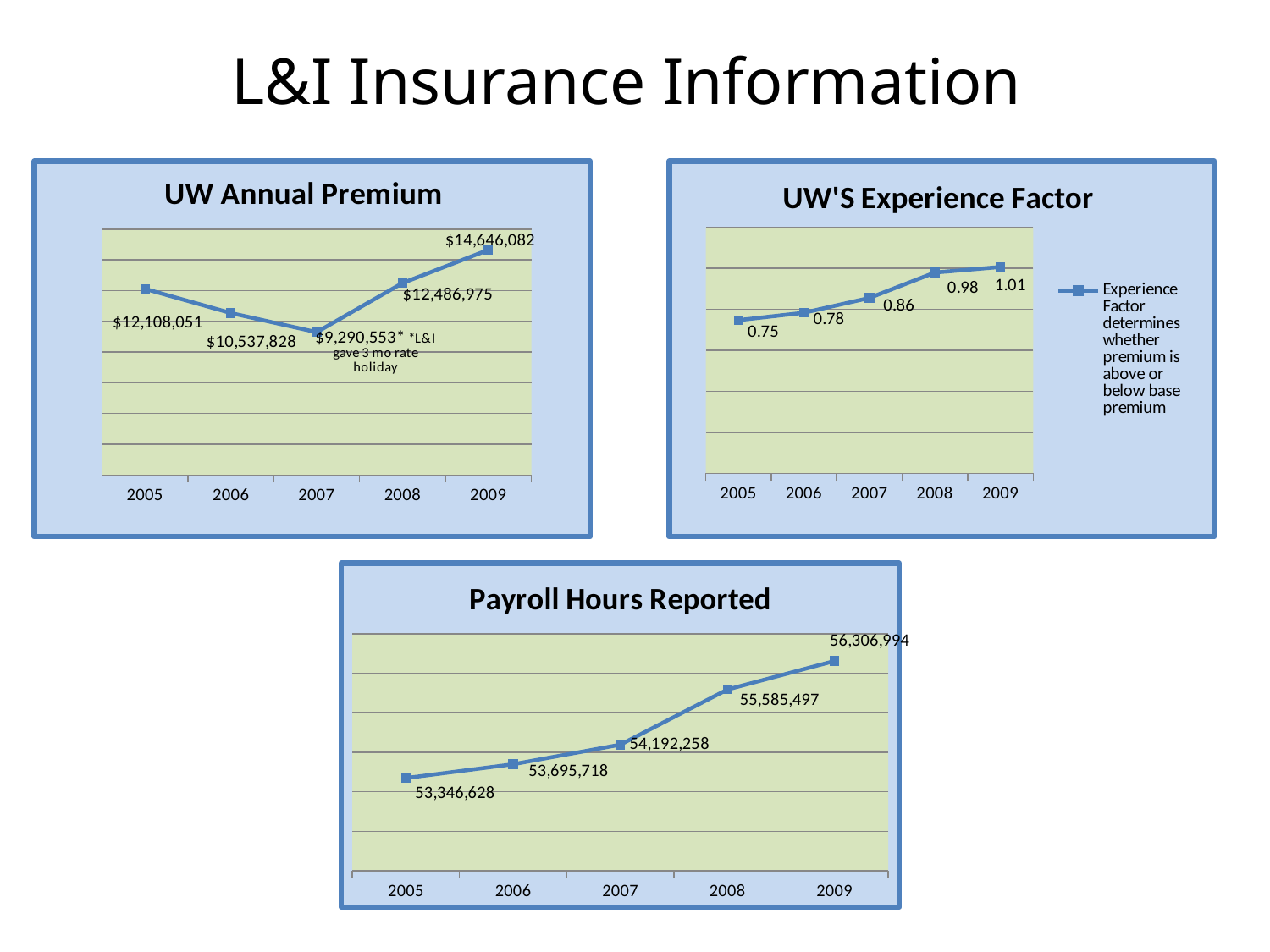
In the Payroll Hours Reported chart, how many years are plotted? 5 In the UW'S Experience Factor chart, which year has the highest experience factor? 2009 In the UW Annual Premium chart, which year has the lowest premium? 2007 What kind of chart is the Payroll Hours Reported chart? line chart In the UW Annual Premium chart, what is the difference between the 2009 and 2008 values? $2,159,107 In the Payroll Hours Reported chart, what is the difference between the 2008 and 2007 values? 1,393,239 In the UW Annual Premium chart, is the value for 2005 or 2006 larger? 2005 In the UW'S Experience Factor chart, how many series does the legend list? 1 In the Payroll Hours Reported chart, what is the value for 2006? 53,695,718 In the UW Annual Premium chart, what is the value for 2009? $14,646,082 In the UW'S Experience Factor chart, do the values rise or fall from 2005 to 2009? rise In the UW'S Experience Factor chart, what is the value for 2007? 0.86